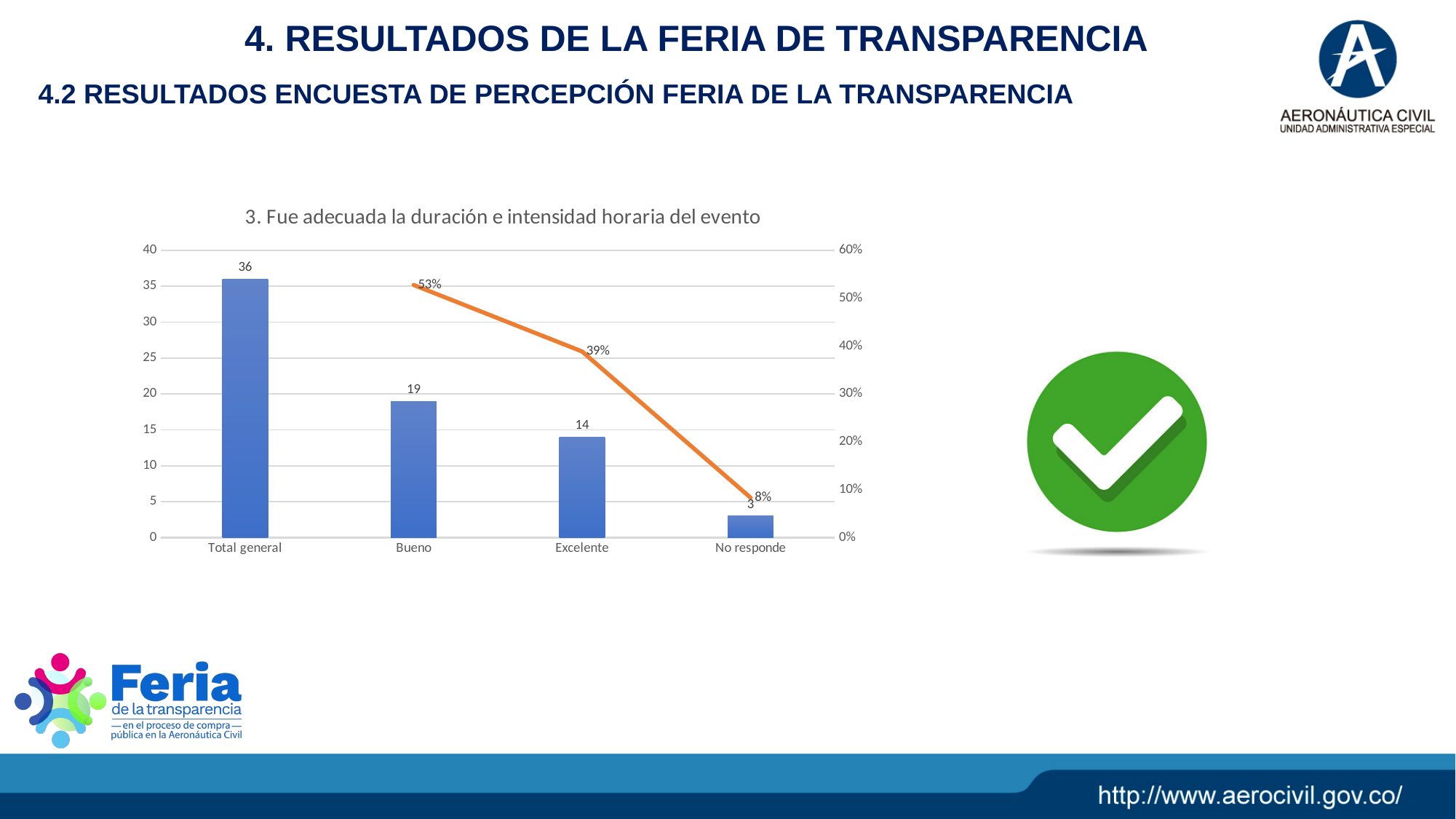
Which category has the lowest bar value? No responde What is the title of the chart? 3. Fue adecuada la duración e intensidad horaria del evento Does the line series rise or fall from Bueno to No responde? fall Which has a larger bar value, Excelente or No responde? Excelente Which category has the highest bar value? Total general What is the bar value for Total general? 36 What is the bar value for No responde? 3 What is the difference between the bar values for Bueno and Excelente? 5 What is the bar value for Bueno? 19 What percentage does the line show for Excelente? 39% How many categories are shown on the x axis? 4 What percentage does the line show for Bueno? 53%